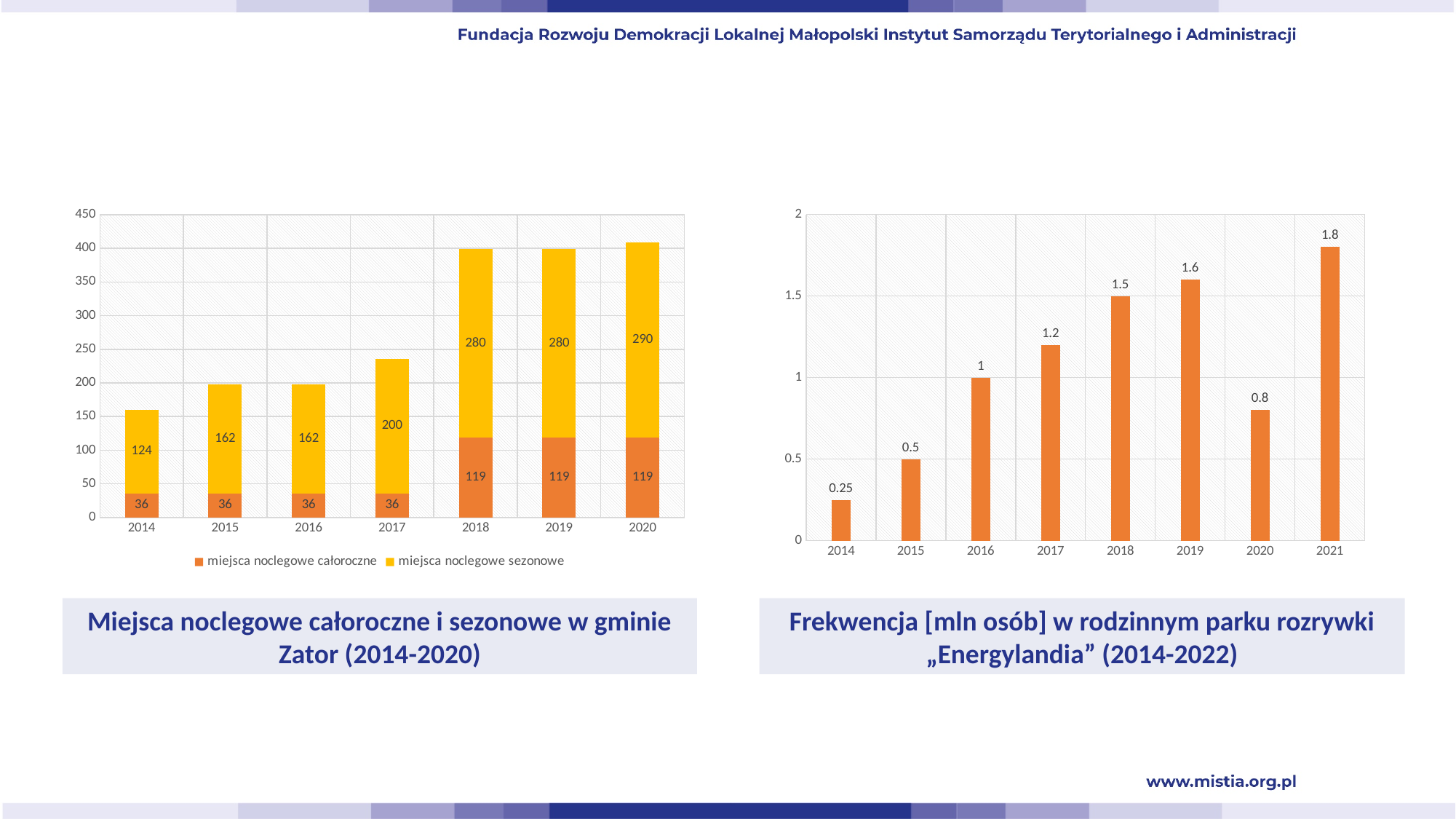
In the left chart (Miejsca noclegowe całoroczne i sezonowe w gminie Zator), which year has the lowest value for miejsca noclegowe sezonowe? 2014 In the left chart (Miejsca noclegowe całoroczne i sezonowe w gminie Zator), what is the total of the stacked bar for 2020? 409 In the right chart (Frekwencja w parku rozrywki Energylandia), how many years are shown on the x axis? 8 In the left chart (Miejsca noclegowe całoroczne i sezonowe w gminie Zator), what is the difference between miejsca noclegowe sezonowe in 2018 and in 2014? 156 What kind of chart is the right chart (Frekwencja w parku rozrywki Energylandia)? bar chart In the right chart (Frekwencja w parku rozrywki Energylandia), what is the value for 2017? 1.2 In the left chart (Miejsca noclegowe całoroczne i sezonowe w gminie Zator), what is the value for miejsca noclegowe sezonowe in 2017? 200 In the right chart (Frekwencja w parku rozrywki Energylandia), which year has the highest value? 2021 In the right chart (Frekwencja w parku rozrywki Energylandia), which year has the lowest value? 2014 In the left chart (Miejsca noclegowe całoroczne i sezonowe w gminie Zator), how many series does the legend list? 2 In the left chart (Miejsca noclegowe całoroczne i sezonowe w gminie Zator), what is the value for miejsca noclegowe całoroczne in 2019? 119 In the right chart (Frekwencja w parku rozrywki Energylandia), which is larger, the value for 2019 or the value for 2020? 2019